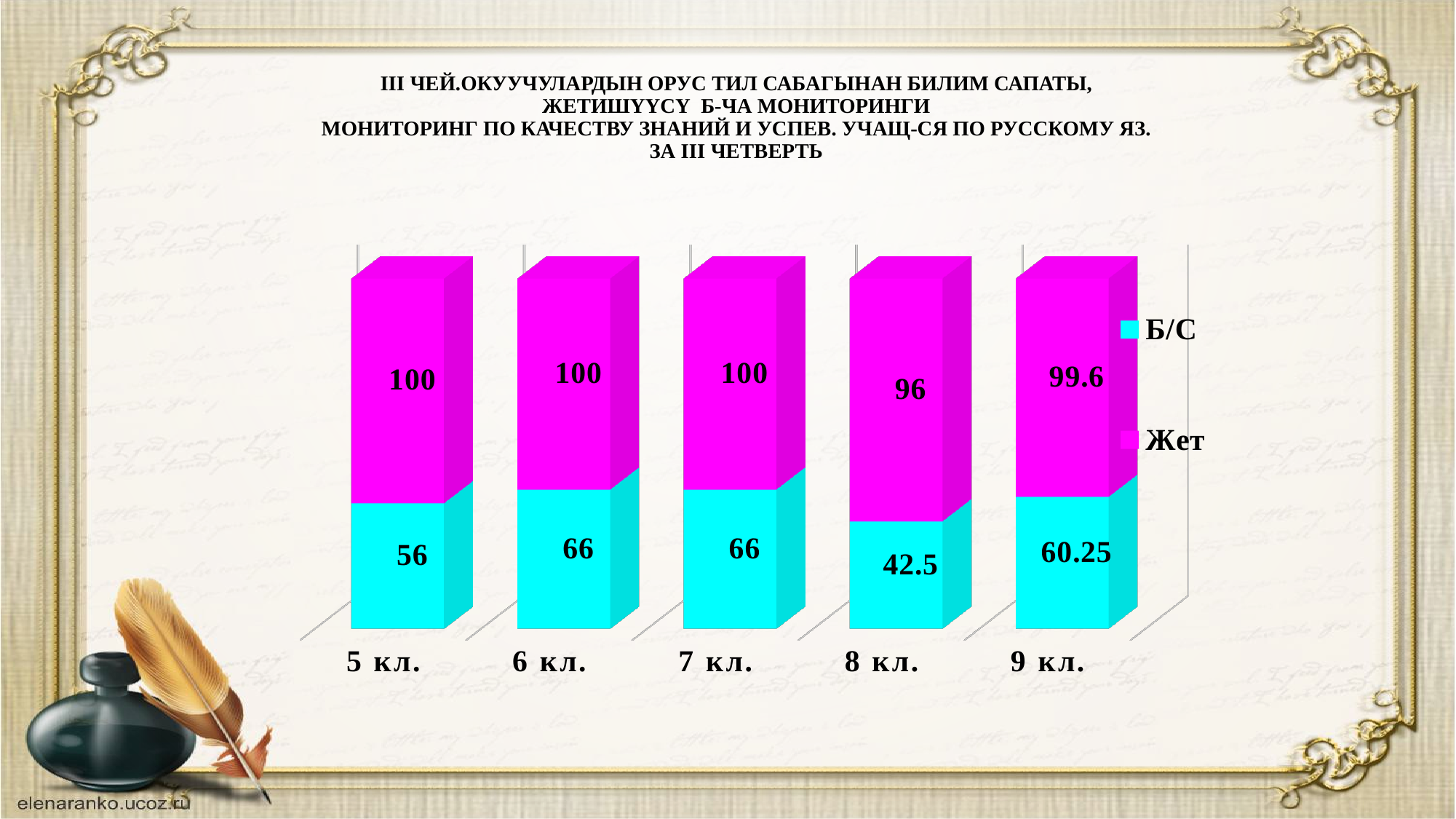
What is the Б/С value for 5 кл.? 56 What is the Б/С value for 9 кл.? 60.25 What is the Жет value for 9 кл.? 99.6 What is the Жет value for 8 кл.? 96 Which class has the lowest Жет value? 8 кл. Which class has the lowest Б/С value? 8 кл. How many series does the legend list? 2 Which is larger, the Б/С value for 5 кл. or for 9 кл.? 9 кл. How many classes are shown on the x axis? 5 What is the total of the stacked bar for 8 кл.? 138.5 What kind of chart is shown on the slide? Stacked bar chart What is the difference between the Б/С values for 6 кл. and 8 кл.? 23.5